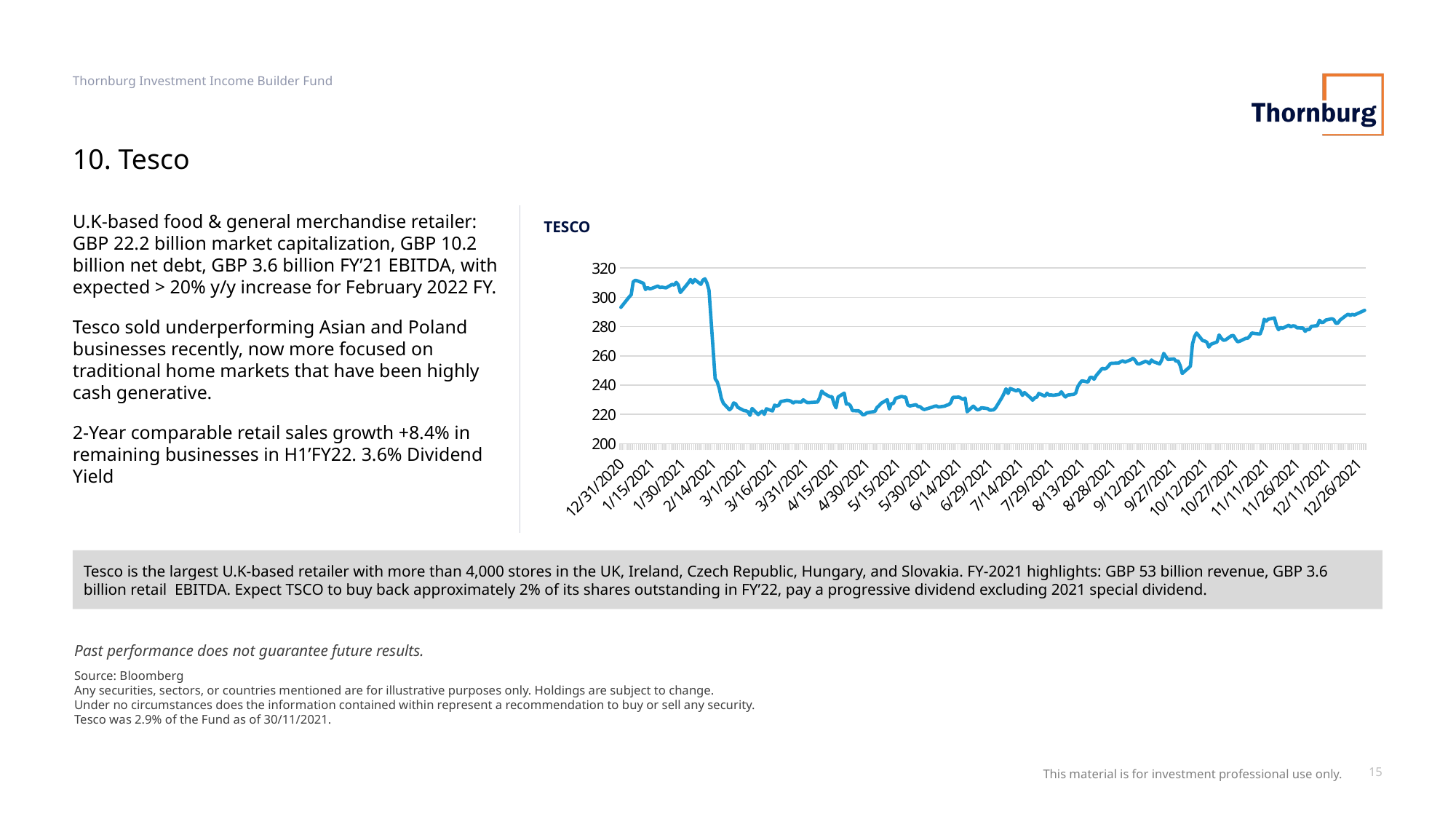
Is the value at 12/26/2021 greater or less than 280? greater Does the line rise or fall between 2/14/2021 and 3/1/2021? fall Is the value at 3/1/2021 greater or less than 240? less What kind of chart is shown on the slide? line chart Is the value at 1/30/2021 larger or smaller than the value at 3/16/2021? larger Does the line generally rise or fall between 7/14/2021 and 12/26/2021? rise What is the title of the chart? TESCO Is the value at 11/11/2021 greater or less than 260? greater What is the highest value shown on the chart's vertical axis? 320